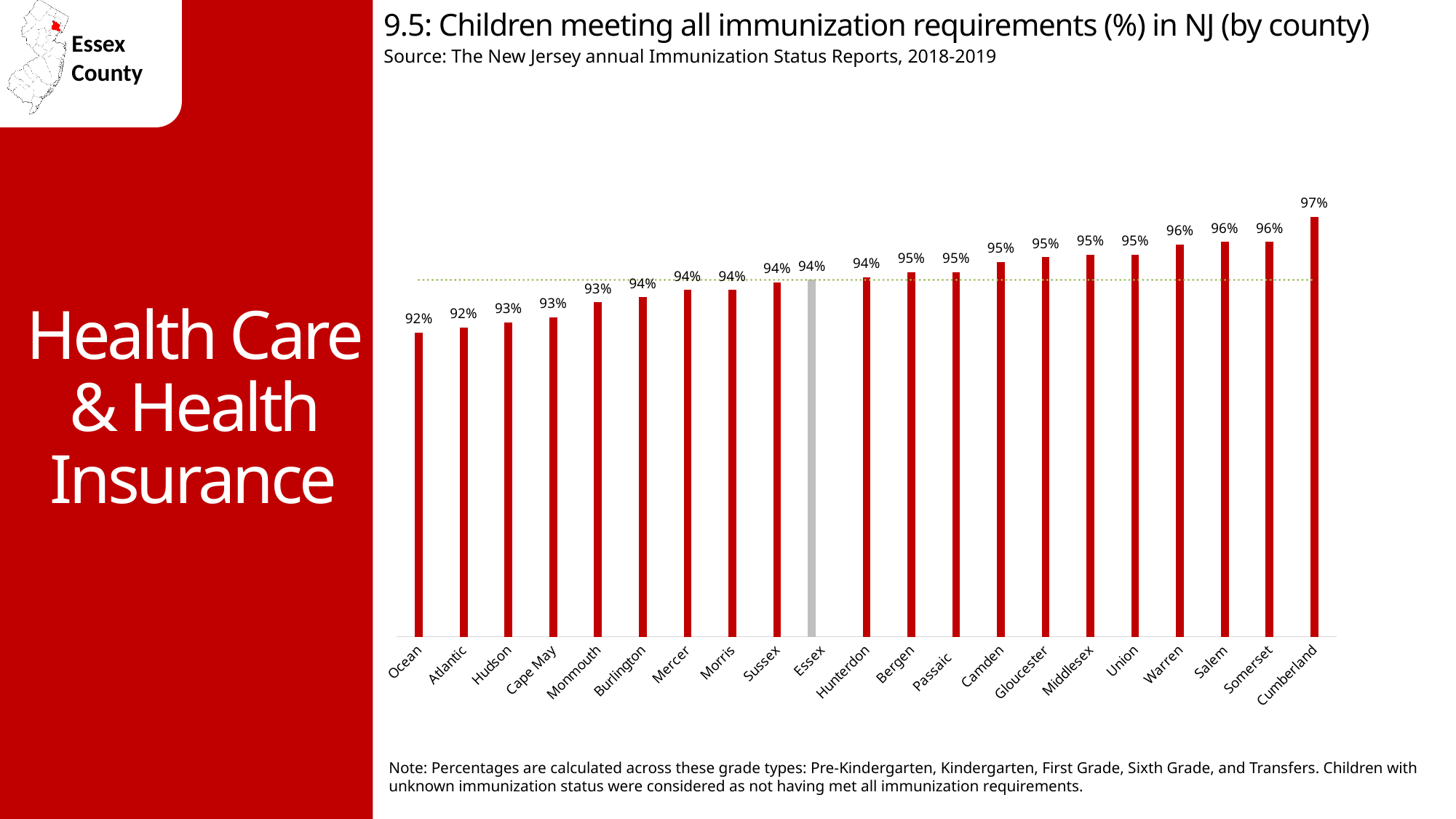
What percentage of children in Essex County met all immunization requirements? 94% How many counties are shown in the chart? 21 What percentage is shown for Warren County? 96% What is the value shown for Cumberland County? 97% Do the values generally rise or fall moving from left to right across the counties? Rise Which county's bar is coloured grey instead of red? Essex What kind of chart is used on this slide? Bar chart Which county has the highest percentage of children meeting all immunization requirements? Cumberland What is the value for Bergen County? 95% What percentage is shown for Ocean County? 92% What is the difference in percentage points between Cumberland and Ocean counties? 5 percentage points Which county has a higher value, Essex or Cumberland? Cumberland